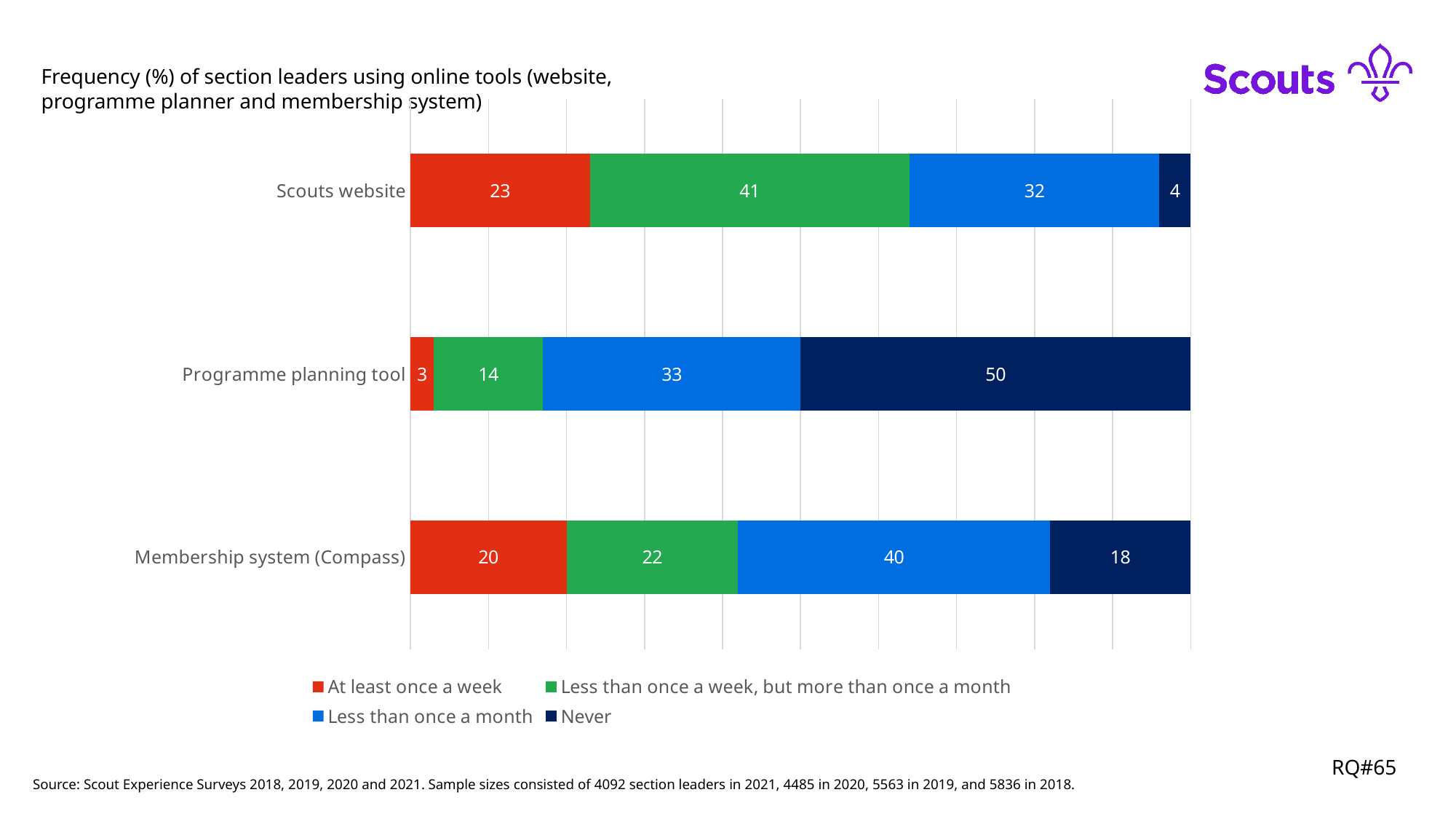
Which has a larger 'Less than once a week, but more than once a month' value: the Scouts website or the Membership system (Compass)? Scouts website What is the difference between the 'Never' percentages for the Membership system (Compass) and the Scouts website? 14 Which tool has the highest percentage of section leaders who never use it? Programme planning tool Which tool has the lowest percentage of section leaders using it at least once a week? Programme planning tool How many series does the legend list? 4 What is the total of the stacked bar for the Programme planning tool? 100 What percentage of section leaders use the Membership system (Compass) less than once a month? 40 How many tools (categories) are shown in the chart? 3 What kind of chart is shown on the slide? Stacked bar chart Which colour represents the 'Never' series in the legend? Dark navy blue What percentage of section leaders never use the Programme planning tool? 50 What percentage of section leaders use the Scouts website at least once a week? 23